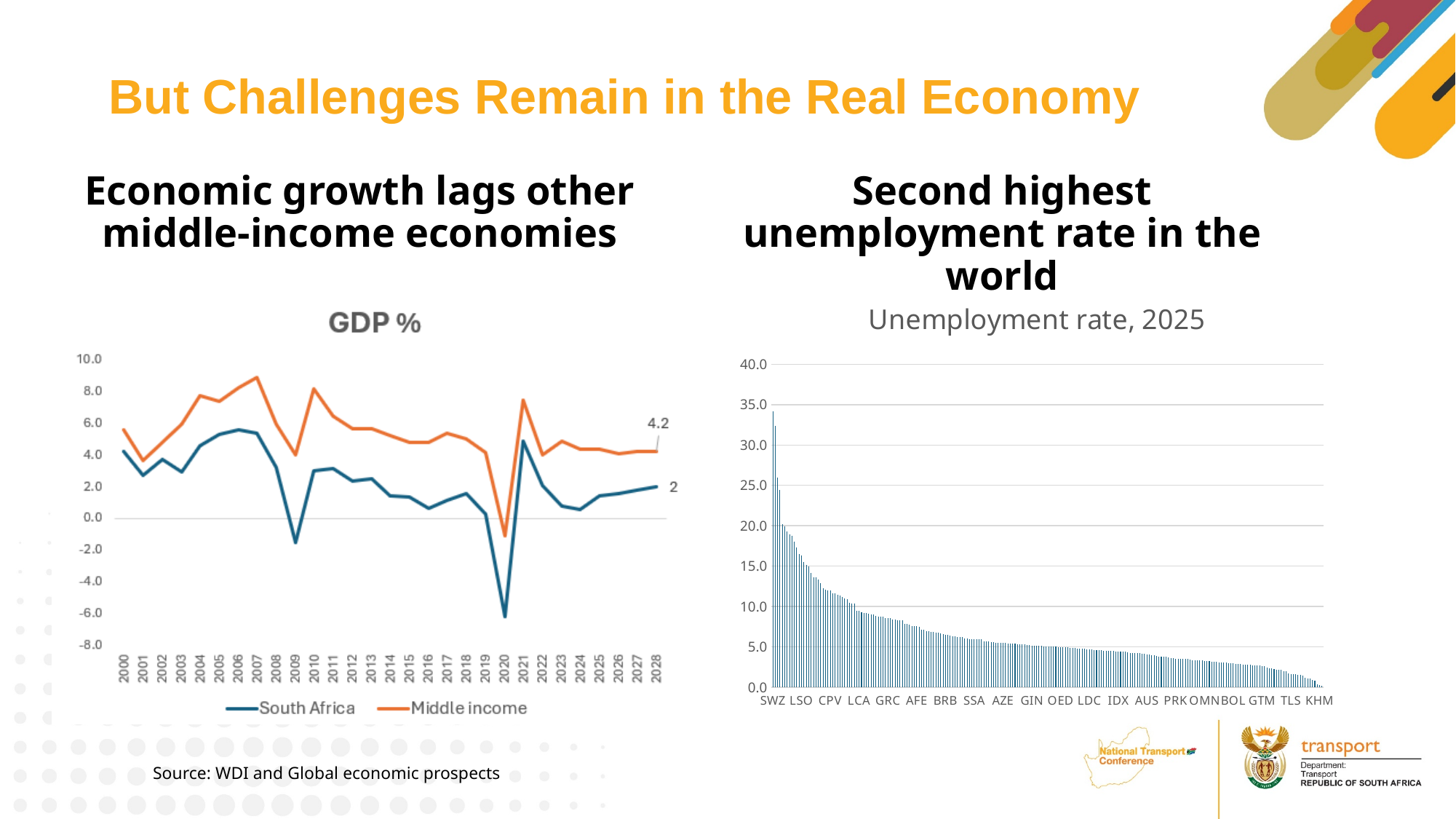
In the GDP % chart, is the value for South Africa in 2020 greater or less than -4.0? less In the GDP % chart, what is the value for Middle income in 2028? 4.2 In the Unemployment rate, 2025 chart, is the value for SWZ greater or less than 30.0? greater What are the two legend entries of the GDP % chart? South Africa, Middle income How many series does the legend of the GDP % chart list? 2 What kind of chart is the Unemployment rate, 2025 chart on the right? bar chart In the GDP % chart, is the value for Middle income in 2007 greater or less than 8.0? greater What kind of chart is the GDP % chart on the left? line chart In the GDP % chart, what is the value for South Africa in 2028? 2 In the Unemployment rate, 2025 chart, do the values rise or fall from left to right along the x axis? fall In the GDP % chart, which series has the larger value in 2028, South Africa or Middle income? Middle income In the GDP % chart, what is the difference between the Middle income and South Africa values in 2028? 2.2